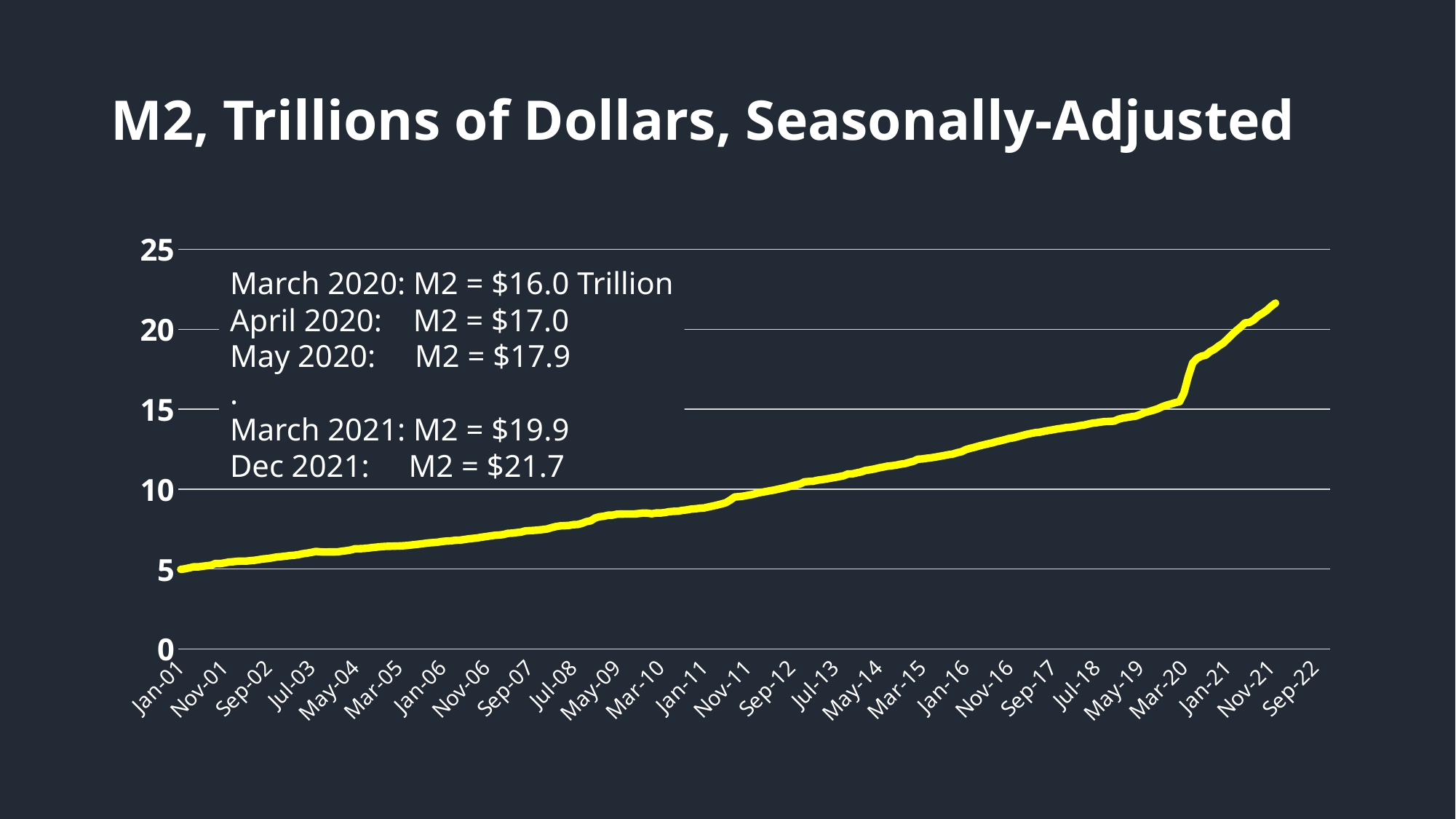
According to the annotation on the chart, what was M2 in Dec 2021? $21.7 What kind of chart is shown on the slide? line chart According to the annotation on the chart, what was M2 in May 2020? $17.9 By how much did M2 increase from March 2021 to Dec 2021, according to the annotated values? $1.8 trillion Is the value of M2 at Jan-01 greater or less than 10? less According to the annotation on the chart, what was M2 in March 2020? $16.0 Trillion According to the annotation on the chart, what was M2 in March 2021? $19.9 According to the annotation on the chart, what was M2 in April 2020? $17.0 What is the title of the chart? M2, Trillions of Dollars, Seasonally-Adjusted Is the value of M2 at Jan-16 greater or less than 10? greater By how much did M2 increase from March 2020 to May 2020, according to the annotated values? $1.9 trillion Does the M2 line generally rise or fall from Jan-01 to Nov-21? rise